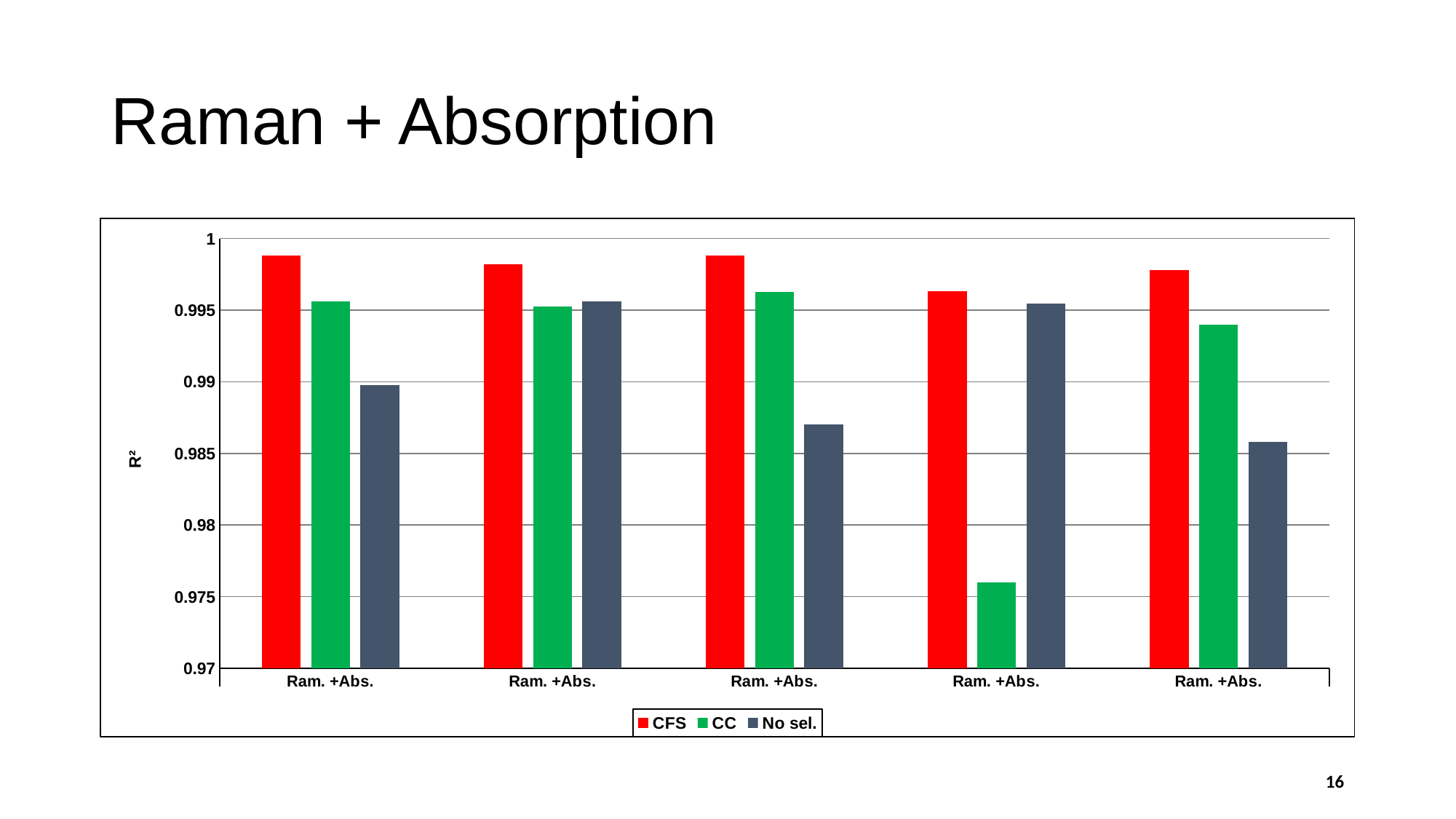
Is the value for No sel. in the first group greater or less than 0.985? greater In the fourth group, which is larger, CFS or CC? CFS Is the value for CC in the fourth group greater or less than 0.98? less What kind of chart is shown on the slide? bar chart Is the value for CFS in the fifth group greater or less than 0.995? greater How many series does the legend list? 3 In the fifth group, which is larger, CC or No sel.? CC Which bar is the lowest in the whole chart? CC in the fourth group Which colour represents the CFS series in the legend? red How many groups of bars are plotted along the x axis? 5 What is the label on the y axis? R²